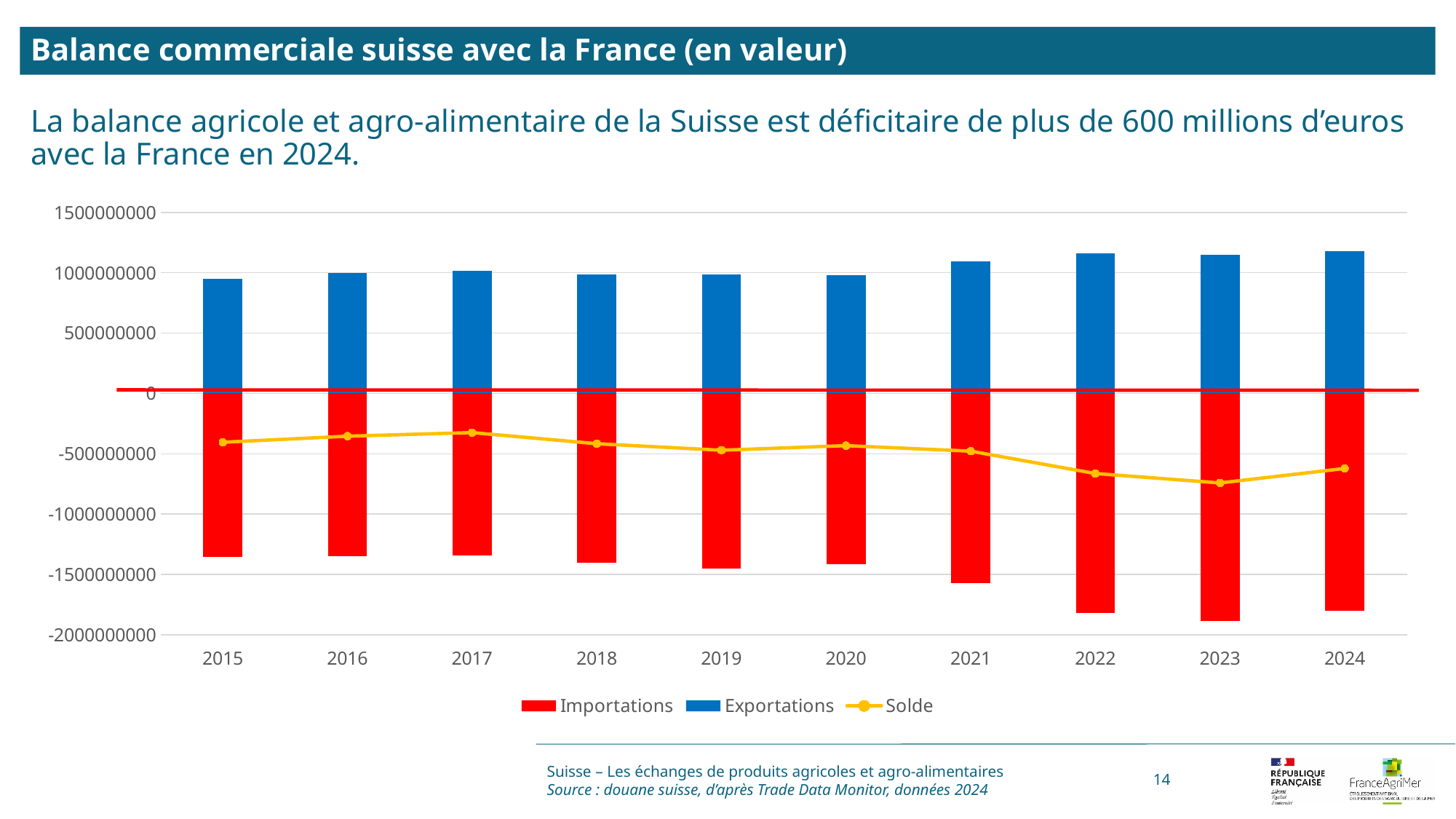
How many years are shown on the x axis? 10 How many series does the legend list? 3 What is the title of the slide containing the chart? Balance commerciale suisse avec la France (en valeur) In which year is the Solde value lowest? 2023 Is the Exportations value for 2024 greater or less than 1000000000? greater Is the Importations value for 2023 greater or less than -1500000000? less Is the Solde value for 2017 greater or less than -500000000? greater Which series is drawn as a yellow line? Solde What kind of chart is shown on the slide? A combined bar and line chart Which year has the larger Exportations value, 2020 or 2021? 2021